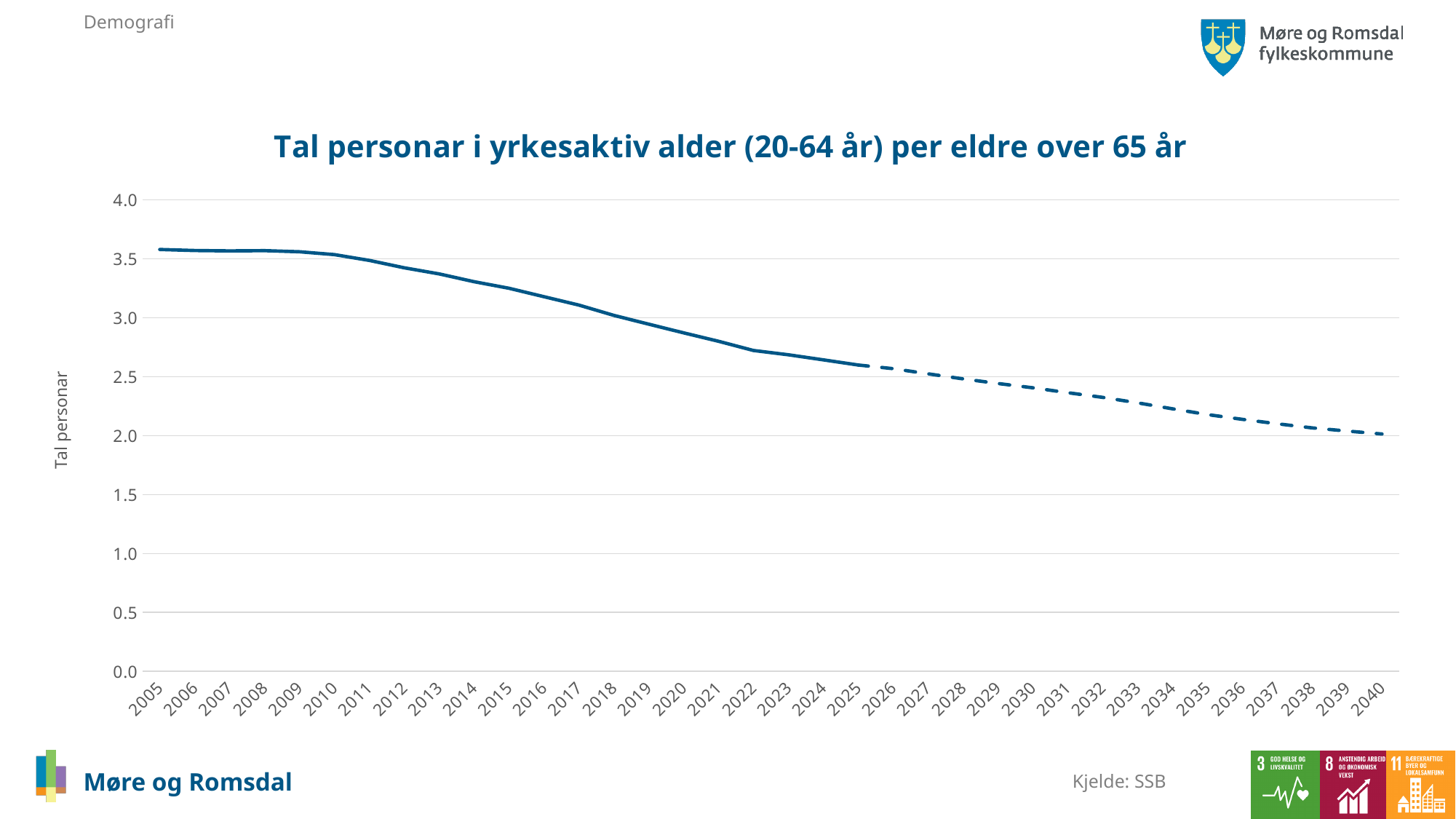
Is the value for 2020 greater or less than 3.0? less What is the label on the y axis? Tal personar What is the title of the chart? Tal personar i yrkesaktiv alder (20-64 år) per eldre over 65 år Do the values rise or fall from 2005 to 2040? fall Is the value for 2005 greater or less than 3.5? greater Which year has the larger value, 2010 or 2035? 2010 How many years are shown on the x axis? 36 Is the value for 2030 greater or less than 2.5? less What kind of chart is shown on the slide? line chart Which year has the lowest value? 2040